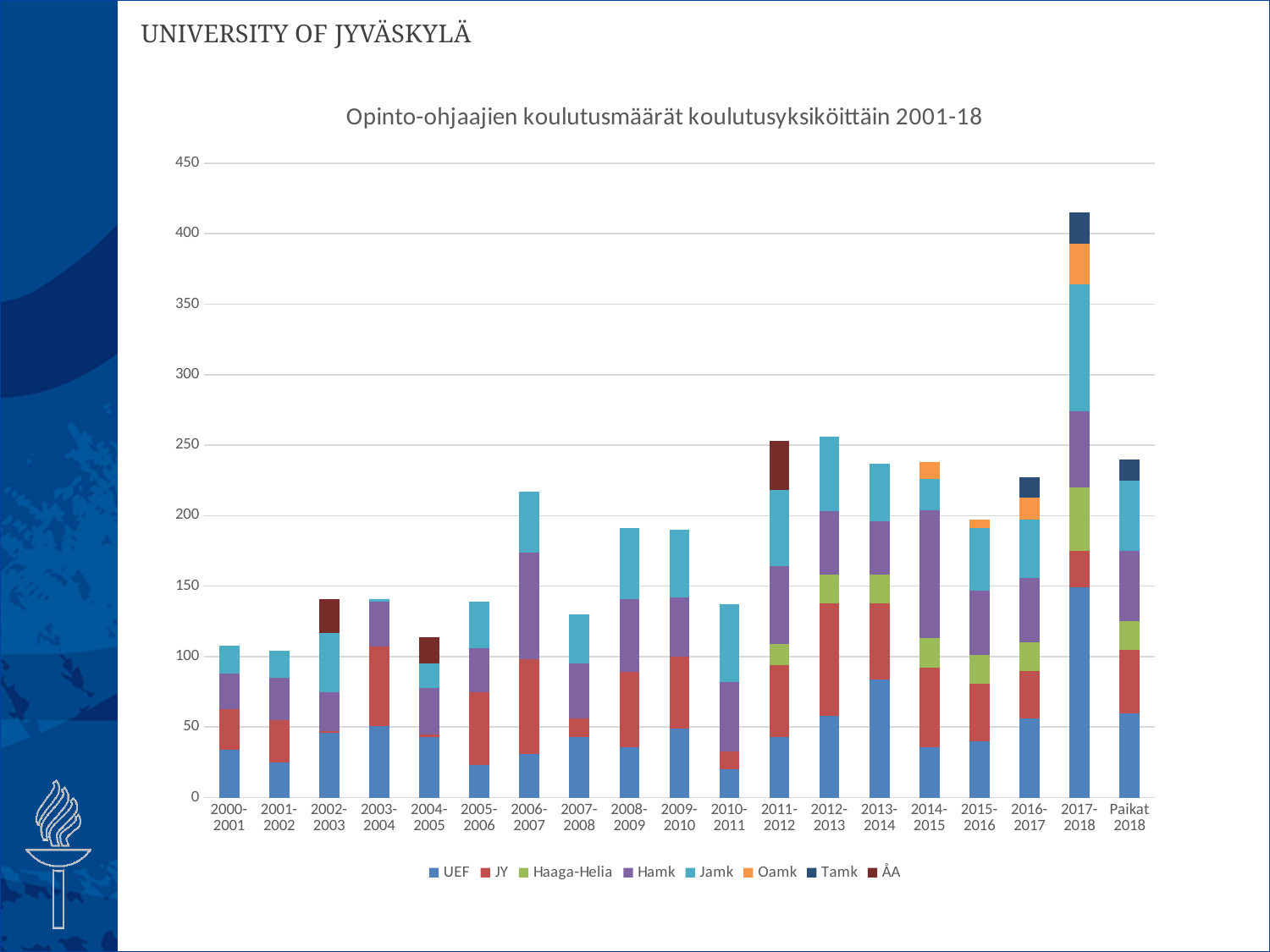
Is the total for 2017-2018 greater or less than 400? greater Which stacked bar is taller, 2017-2018 or 2012-2013? 2017-2018 Is the total for 2013-2014 greater or less than 250? less Is the total for 2006-2007 greater or less than 200? greater How many series does the legend list? 8 Which series is shown at the bottom of each stacked bar, according to the legend? UEF How many bars (categories) are shown along the x axis? 19 What is the title of the chart? Opinto-ohjaajien koulutusmäärät koulutusyksiköittäin 2001-18 Which stacked bar is taller, 2011-2012 or 2007-2008? 2011-2012 What kind of chart is shown on the slide? stacked bar chart Which category has the tallest stacked bar? 2017-2018